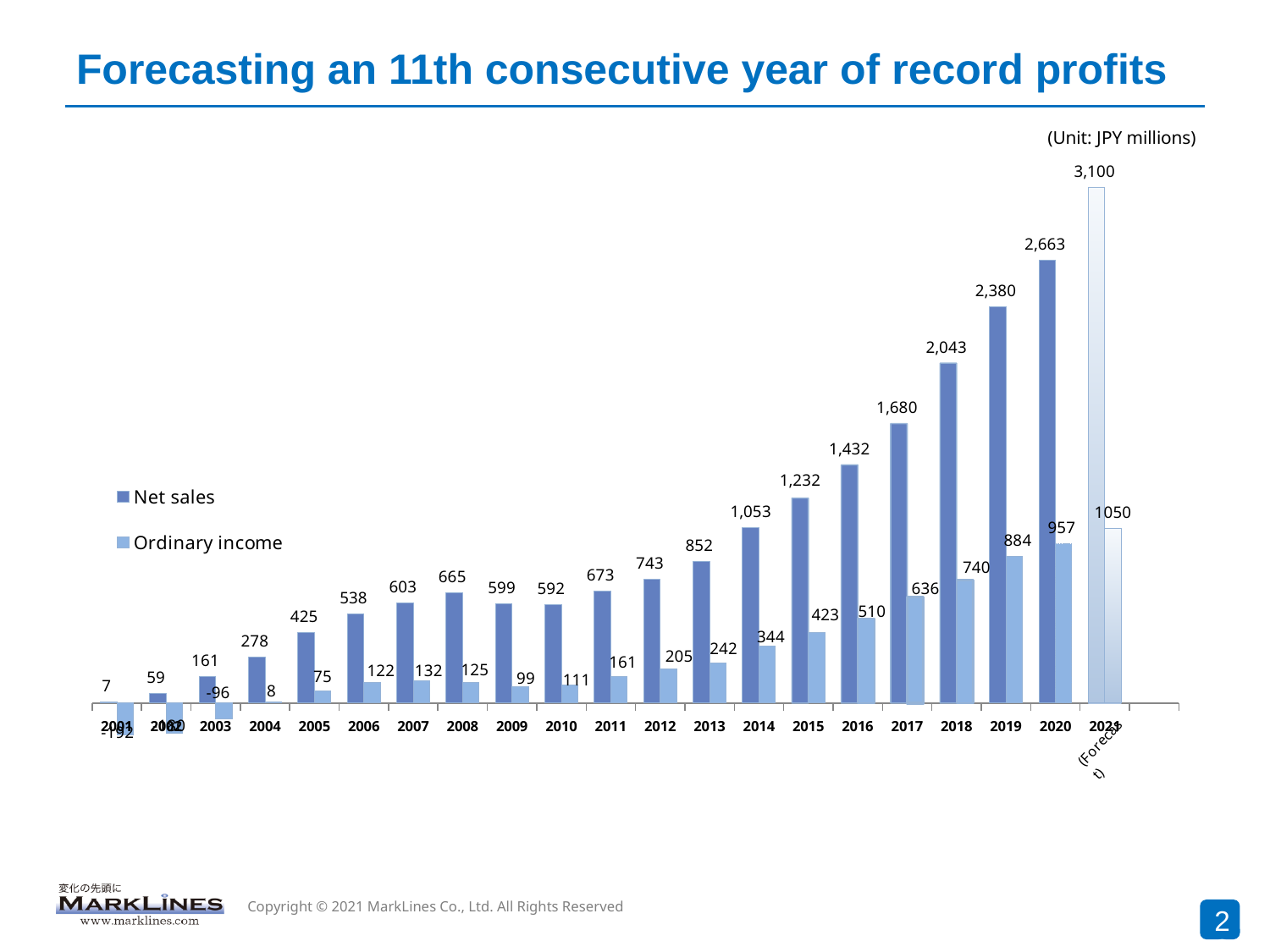
What is the Net sales value for 2020? 2,663 Which year has the highest Net sales value? 2021 (Forecast) What unit is stated for the values in the chart? JPY millions How many series does the legend list? 2 What is the Ordinary income value for 2018? 740 Which is larger, Net sales in 2009 or Net sales in 2010? Net sales in 2009 Which year has the lowest Net sales value? 2001 What is the difference between Net sales and Ordinary income in 2019? 1,496 What is the Ordinary income value for 2003? -96 Do Net sales generally rise or fall from 2010 to 2020? Rise What is the forecast Net sales value for 2021? 3,100 What kind of chart is shown on the slide? Bar chart